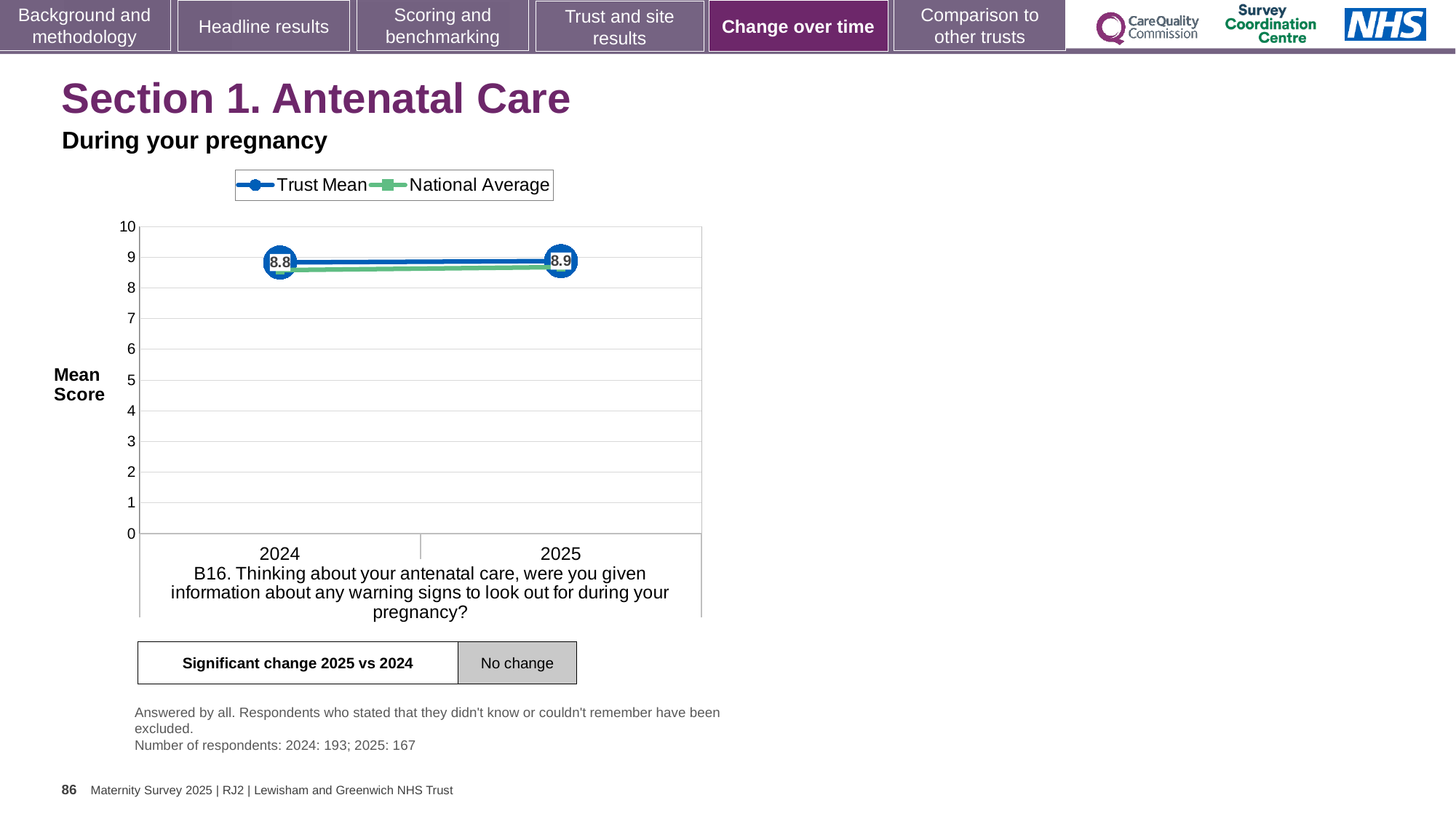
By how much did the Trust Mean change from 2024 to 2025? 0.1 What is the Trust Mean score for 2025? 8.9 What kind of chart is shown on the slide? line chart Is the National Average value for 2024 greater or less than 8? greater In which year is the Trust Mean higher? 2025 What is the label on the y axis of the chart? Mean Score In 2024, which is higher: the Trust Mean or the National Average? Trust Mean How many series does the legend list? 2 What is the Trust Mean score for 2024? 8.8 How many years are plotted on the x axis? 2 Is the National Average value for 2025 greater or less than 9? less Does the Trust Mean rise or fall from 2024 to 2025? rise